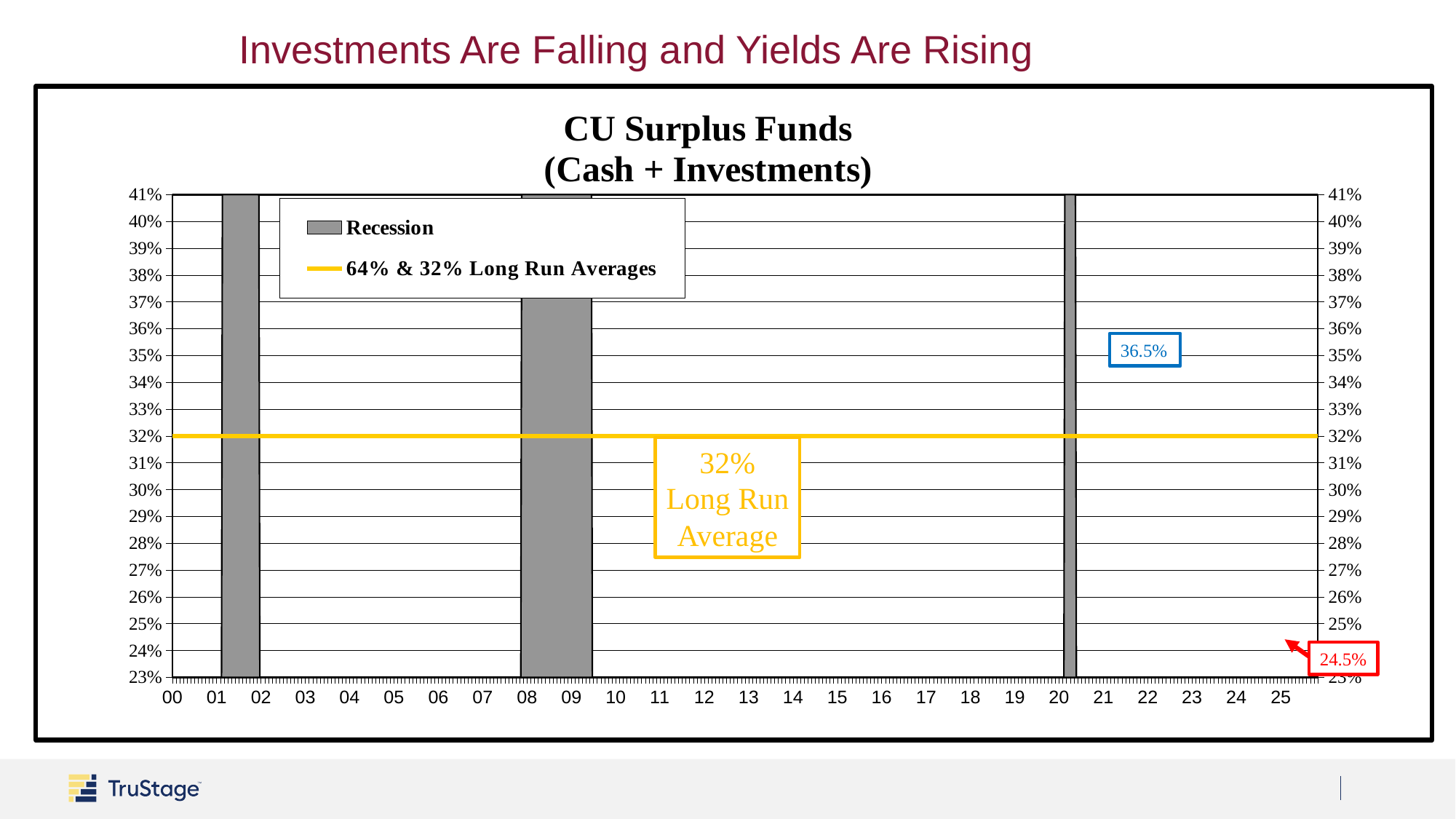
Is the yellow long run average line greater or less than 30%? greater How many gray recession bars are shown on the chart? 3 What value is shown in the blue callout box on the chart? 36.5% What is the title of the chart? CU Surplus Funds (Cash + Investments) What does the yellow line in the legend represent? 64% & 32% Long Run Averages What is the difference between the blue callout value (36.5%) and the red callout value (24.5%)? 12 percentage points Is the yellow long run average line greater or less than 35%? less At what value is the yellow long run average line drawn on the chart? 32% Which is larger, the value in the blue callout (36.5%) or the value in the red callout (24.5%)? 36.5% What value is shown in the red callout box on the chart? 24.5% How many entries does the chart legend list? 2 How many year labels are shown along the x axis? 26